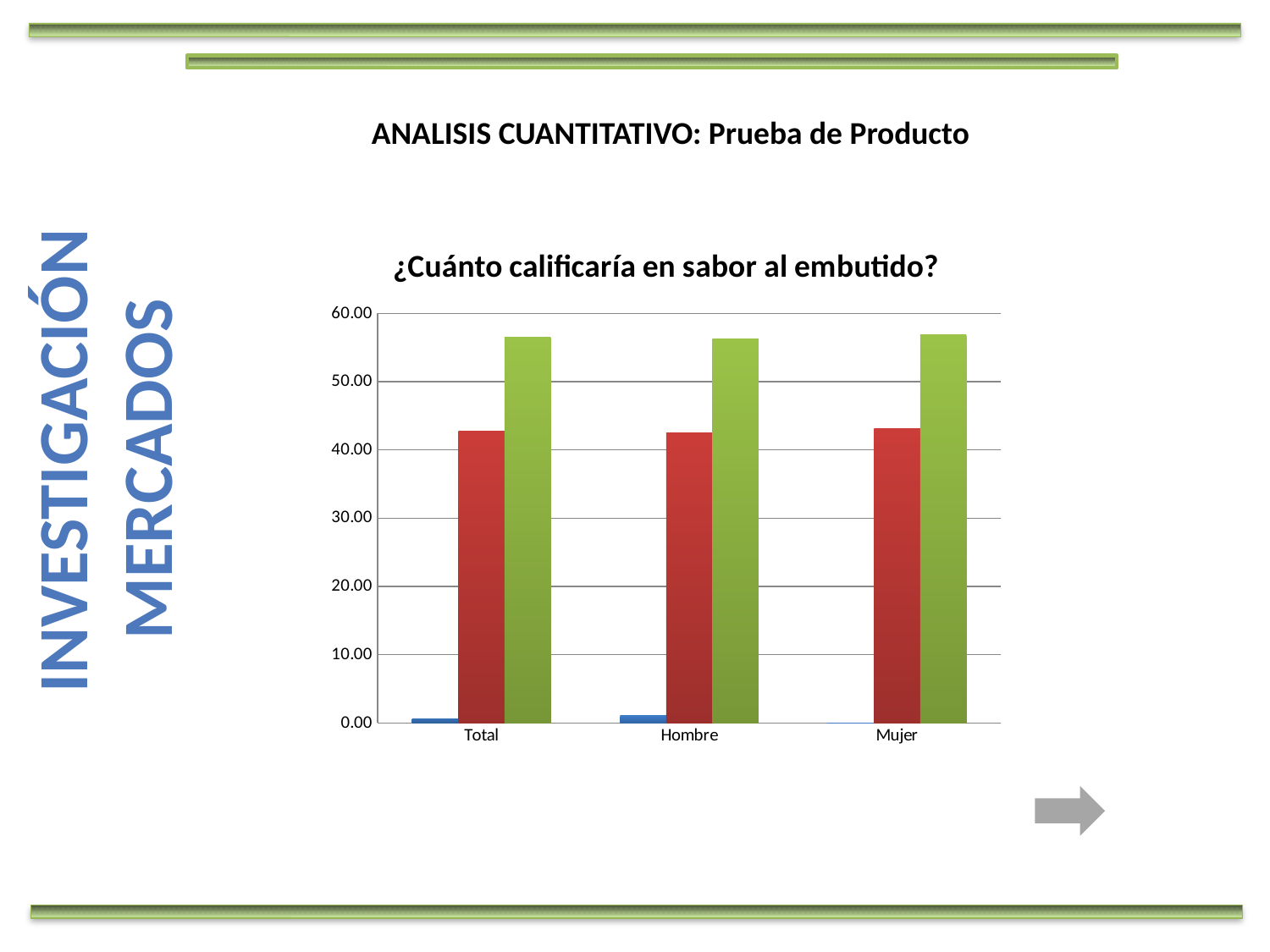
For the Total category, which bar is taller, the green bar or the red bar? the green bar What is the title of the chart? ¿Cuánto calificaría en sabor al embutido? Is the value of the red bar for Hombre greater or less than 40? greater Is the value of the green bar for Hombre greater or less than 60? less For the Mujer category, which bar is taller, the red bar or the blue bar? the red bar Is the value of the green bar for Mujer greater or less than 50? greater What kind of chart is shown on the slide? bar chart How many categories are shown on the x axis of the chart? 3 What are the category labels on the x axis of the chart? Total, Hombre, Mujer